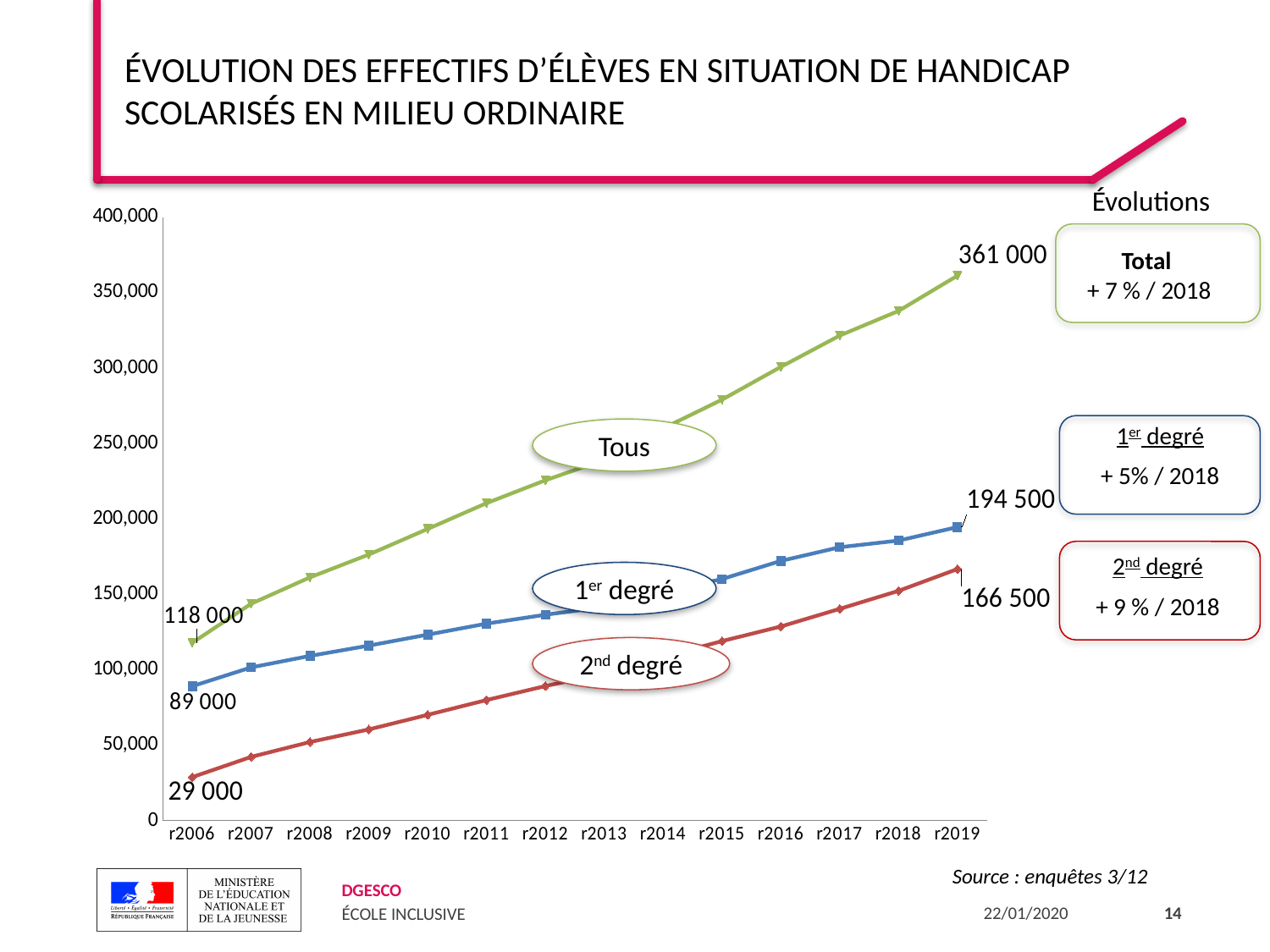
What is the value of the '2nd degré' series in r2006? 29 000 What is the value of the '1er degré' series in r2006? 89 000 By how much did the 'Tous' series increase between r2006 and r2019? 243 000 Which series has the highest value in r2019? Tous What kind of chart is shown on the slide? line chart Is the value of the 'Tous' series in r2015 greater or less than 250,000? greater What is the value of the '2nd degré' series in r2019? 166 500 What is the value of the 'Tous' series in r2019? 361 000 How many years are shown on the x axis? 14 What is the value of the 'Tous' series in r2006? 118 000 What is the difference between the '1er degré' and '2nd degré' values in r2019? 28 000 Which series has the lowest value in r2006? 2nd degré